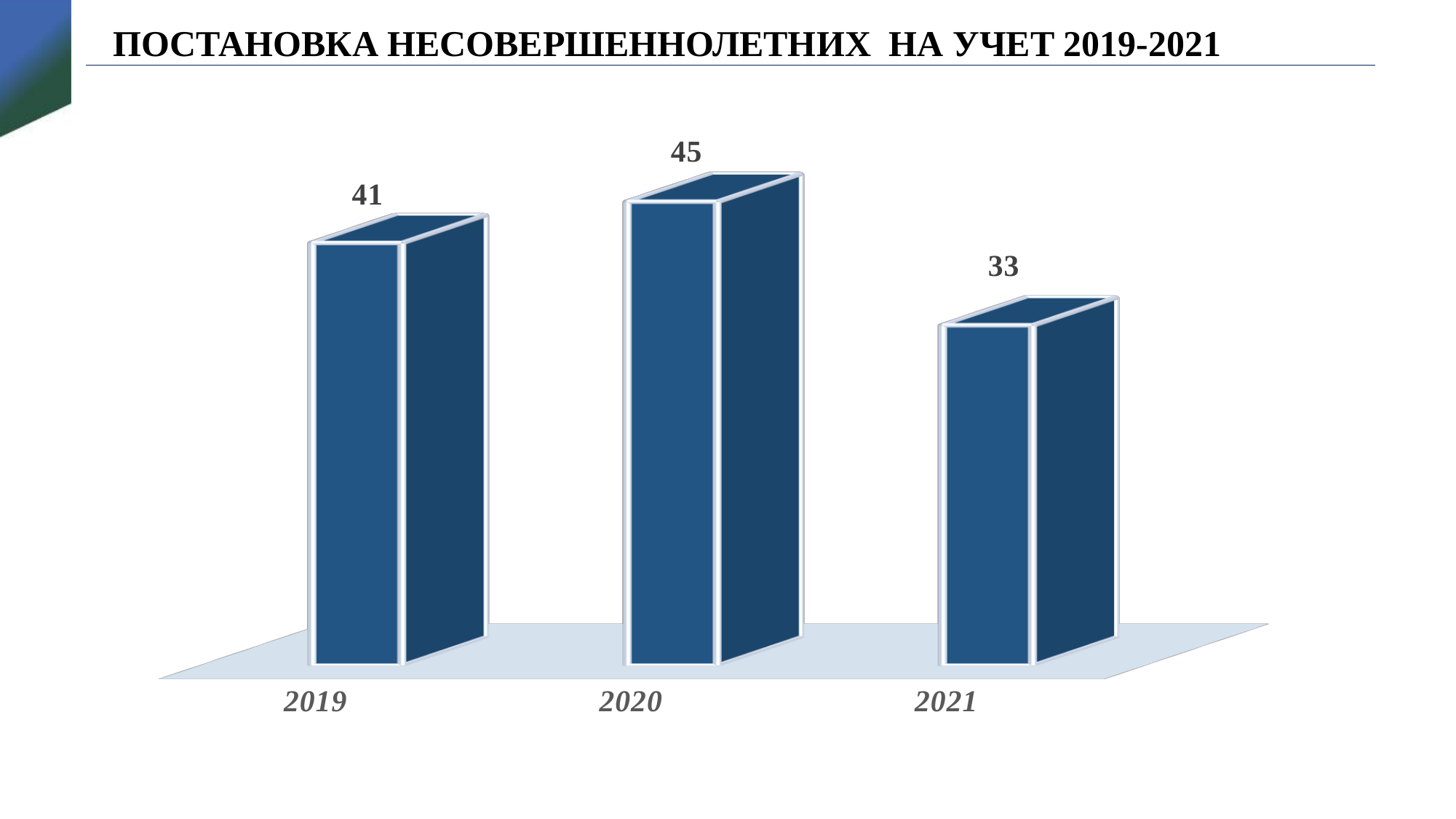
What is the value for 2019? 41 What is the difference between the values for 2020 and 2021? 12 What is the value for 2021? 33 What is the title of the slide? ПОСТАНОВКА НЕСОВЕРШЕННОЛЕТНИХ НА УЧЕТ 2019-2021 Does the value rise or fall from 2020 to 2021? fall What kind of chart is shown on the slide? bar chart What is the difference between the values for 2020 and 2019? 4 Which is larger, the value for 2019 or the value for 2021? 2019 What is the value for 2020? 45 Which year has the highest value? 2020 How many years are shown on the chart? 3 Which year has the lowest value? 2021